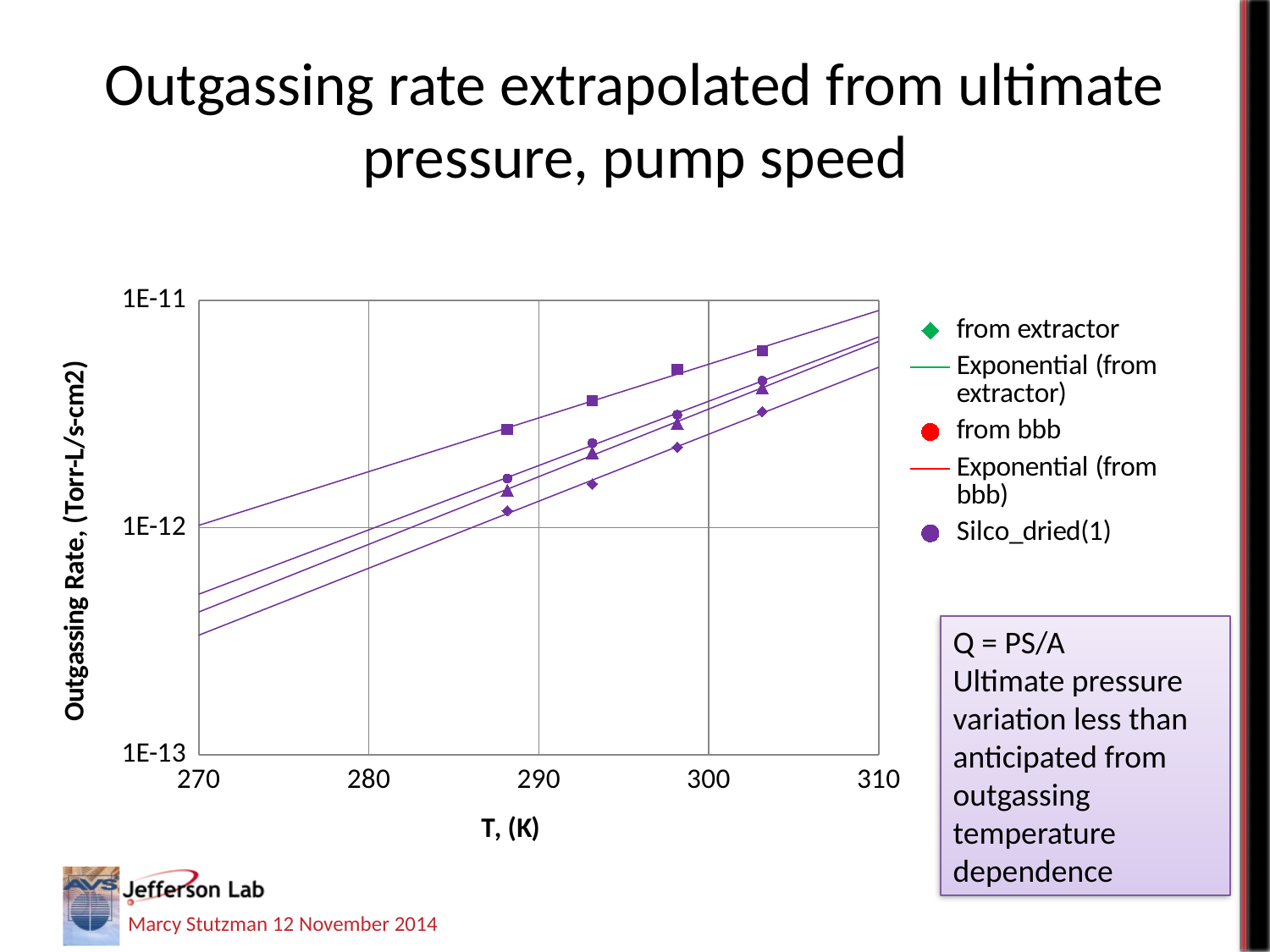
What is the lowest temperature shown on the x axis of the chart? 270 What is the title of the chart's x axis? T, (K) Is the highest plotted outgassing rate value on the chart greater or less than 1E-11? less At about 303 K, which is larger: the square-marker series value or the 'from extractor' (diamond) value? the square-marker series What is the title of the chart's y axis? Outgassing Rate, (Torr-L/s-cm2) Is the 'from extractor' value at about 303 K greater or less than 1E-12? greater How many data points are plotted for the 'from extractor' series (diamond markers)? 4 Do the outgassing rate values rise or fall as temperature increases along the x axis? rise What is the highest temperature shown on the x axis of the chart? 310 What kind of chart is shown on the slide? scatter chart with trend lines How many entries does the chart legend list? 5 Is the lowest plotted outgassing rate value on the chart greater or less than 1E-13? greater